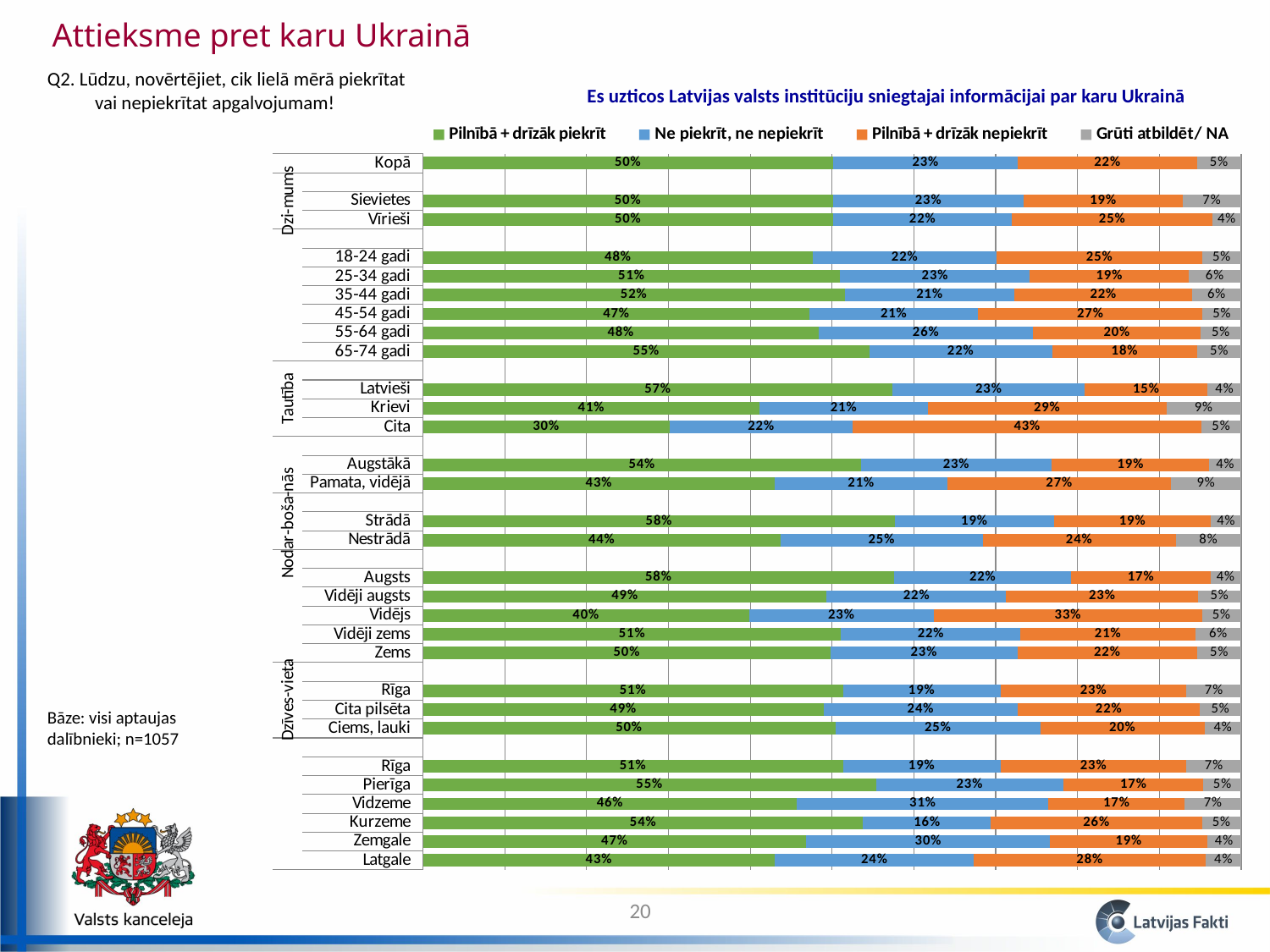
Which category has the highest value for "Pilnībā + drīzāk nepiekrīt"? Cita Which category has the lowest value for "Pilnībā + drīzāk piekrīt"? Cita What is the value of "Pilnībā + drīzāk piekrīt" for Kopā? 50% Which has a larger "Pilnībā + drīzāk nepiekrīt" value, Vidējs or Augsts? Vidējs What is the value of "Grūti atbildēt/ NA" for Pamata, vidējā? 9% What kind of chart is shown on the slide? Stacked bar chart What is the difference between the "Pilnībā + drīzāk piekrīt" values for Latvieši and Krievi? 16% Which category has the lowest value for "Ne piekrīt, ne nepiekrīt"? Kurzeme What is the value of "Pilnībā + drīzāk nepiekrīt" for Krievi? 29% What is the title of the chart? Es uzticos Latvijas valsts institūciju sniegtajai informācijai par karu Ukrainā What is the value of "Ne piekrīt, ne nepiekrīt" for Vidzeme? 31% How many series does the legend list? 4